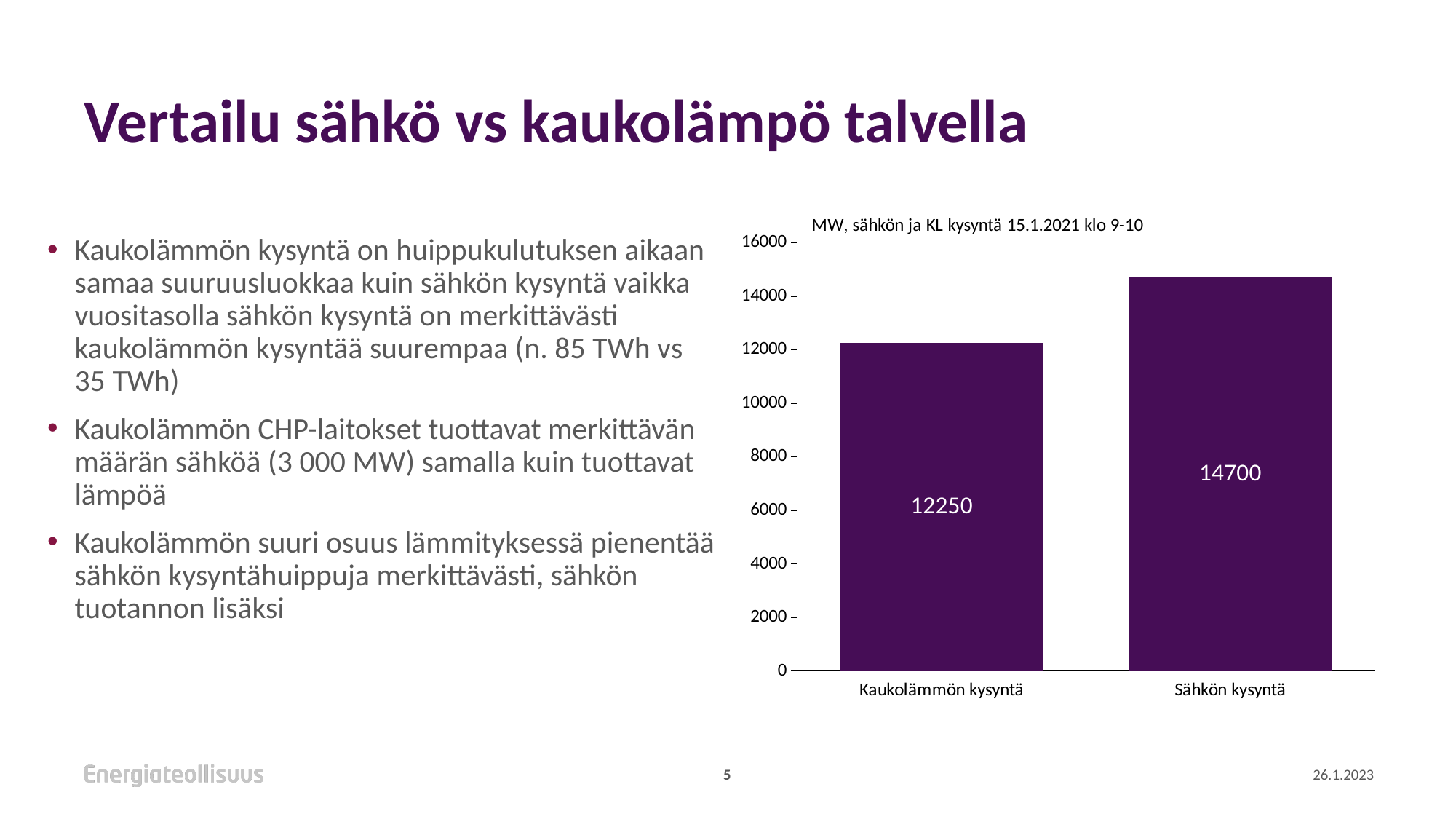
Which category has the lowest value? Kaukolämmön kysyntä What is the value for Kaukolämmön kysyntä? 12250 What is the difference between the values for Sähkön kysyntä and Kaukolämmön kysyntä? 2450 Is the value for Sähkön kysyntä greater or less than 14000? greater How many categories are shown in the chart? 2 Which is larger, Kaukolämmön kysyntä or Sähkön kysyntä? Sähkön kysyntä What is the highest value shown on the vertical axis of the chart? 16000 Which category has the highest value? Sähkön kysyntä What is the title of the chart? MW, sähkön ja KL kysyntä 15.1.2021 klo 9-10 Is the value for Kaukolämmön kysyntä greater or less than 14000? less What is the value for Sähkön kysyntä? 14700 What kind of chart is shown on the slide? bar chart